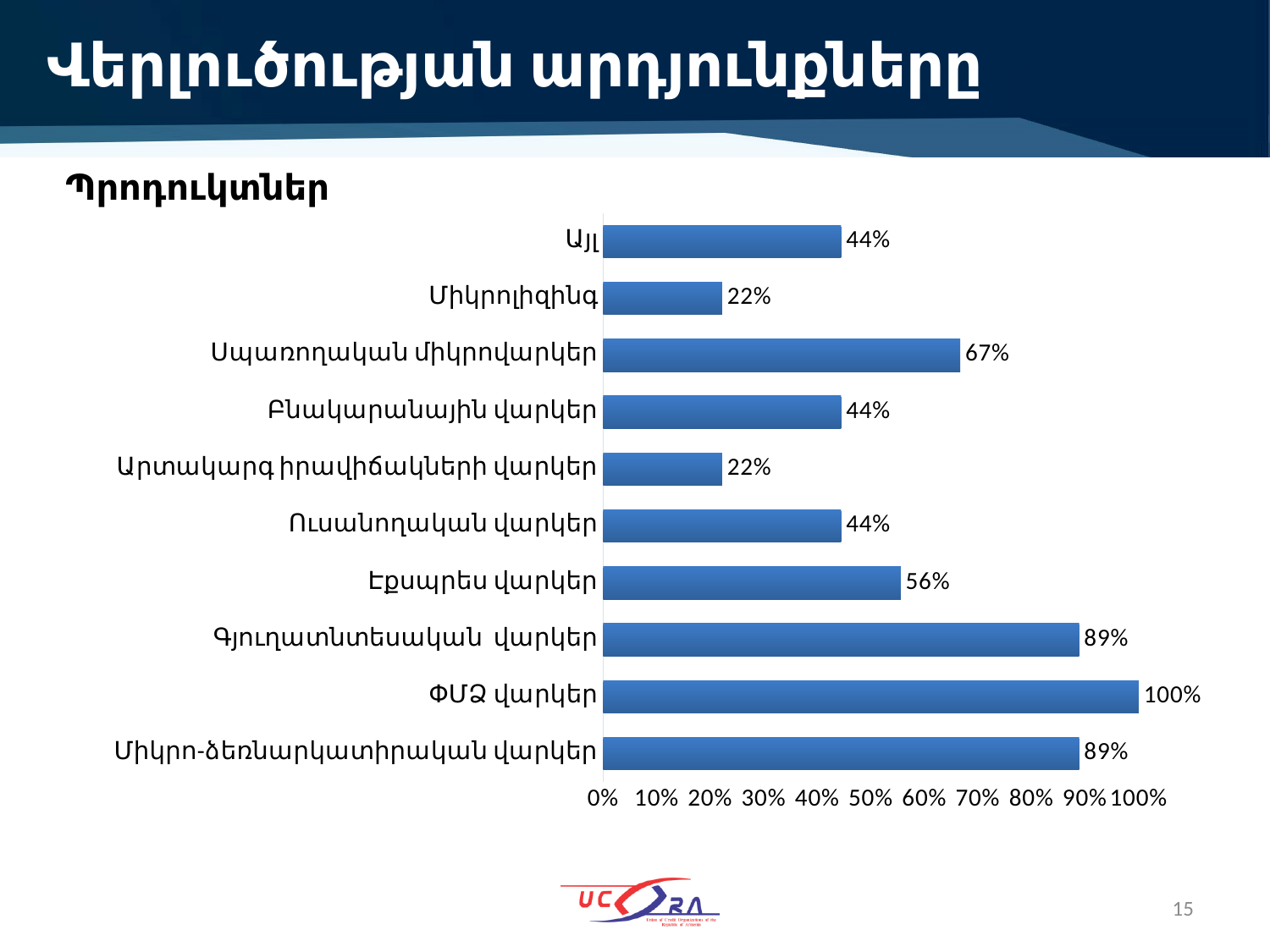
What kind of chart is shown on the slide? bar chart Is the value for Միկրո-ձեռնարկատիրական վարկեր greater or less than 80%? greater What value is shown for Էքսպրես վարկեր? 56% How many categories are shown in the chart? 10 Which is larger, the value for Բնակարանային վարկեր or the value for Արտակարգ իրավիճակների վարկեր? Բնակարանային վարկեր What is the difference between the values for Սպառողական միկրովարկեր and Միկրոլիզինգ? 45% What value is shown for Միկրոլիզինգ? 22% What is the difference between the values for ՓՄՁ վարկեր and Էքսպրես վարկեր? 44% What value is shown for Գյուղատնտեսական վարկեր? 89% What value is shown for Սպառողական միկրովարկեր? 67% What is the title of the chart? Պրոդուկտներ Which category has the highest value? ՓՄՁ վարկեր